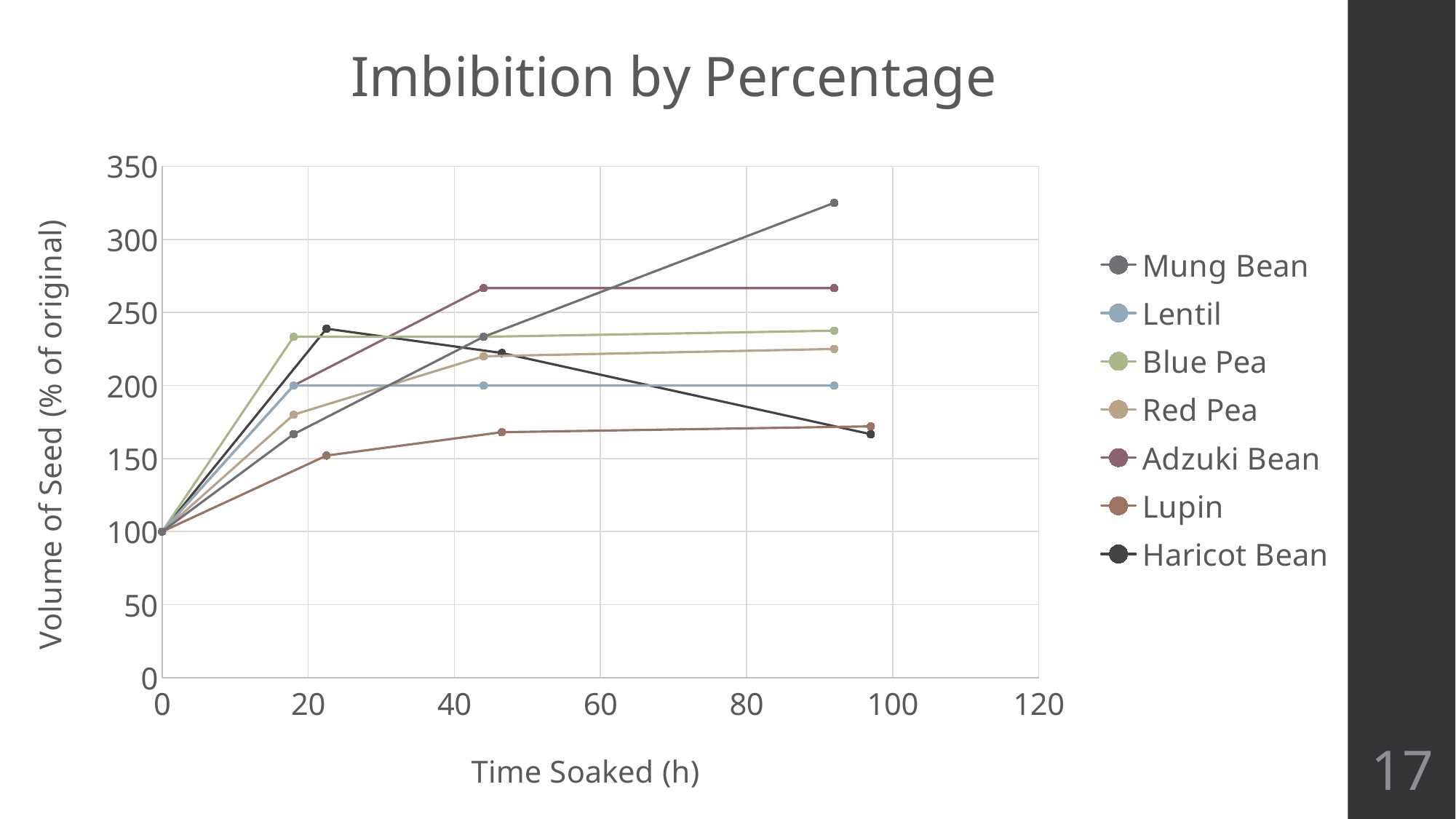
Is the final value for Mung Bean greater or less than 300? greater What is the label of the x axis? Time Soaked (h) Does the Haricot Bean series rise or fall after its peak at around 22 hours? fall What is the value for Lentil at around 44 hours soaked? 200 How many series does the legend list? 7 At the final time point, which is larger: Adzuki Bean or Lentil? Adzuki Bean Is the final value for Haricot Bean greater or less than 200? less What kind of chart is shown on the slide? line chart What is the value for all series at 0 hours soaked? 100 What is the title of the chart? Imbibition by Percentage Which series has the highest value at the final time point (around 92 hours)? Mung Bean Which series has the lowest value at around 20 hours soaked? Lupin